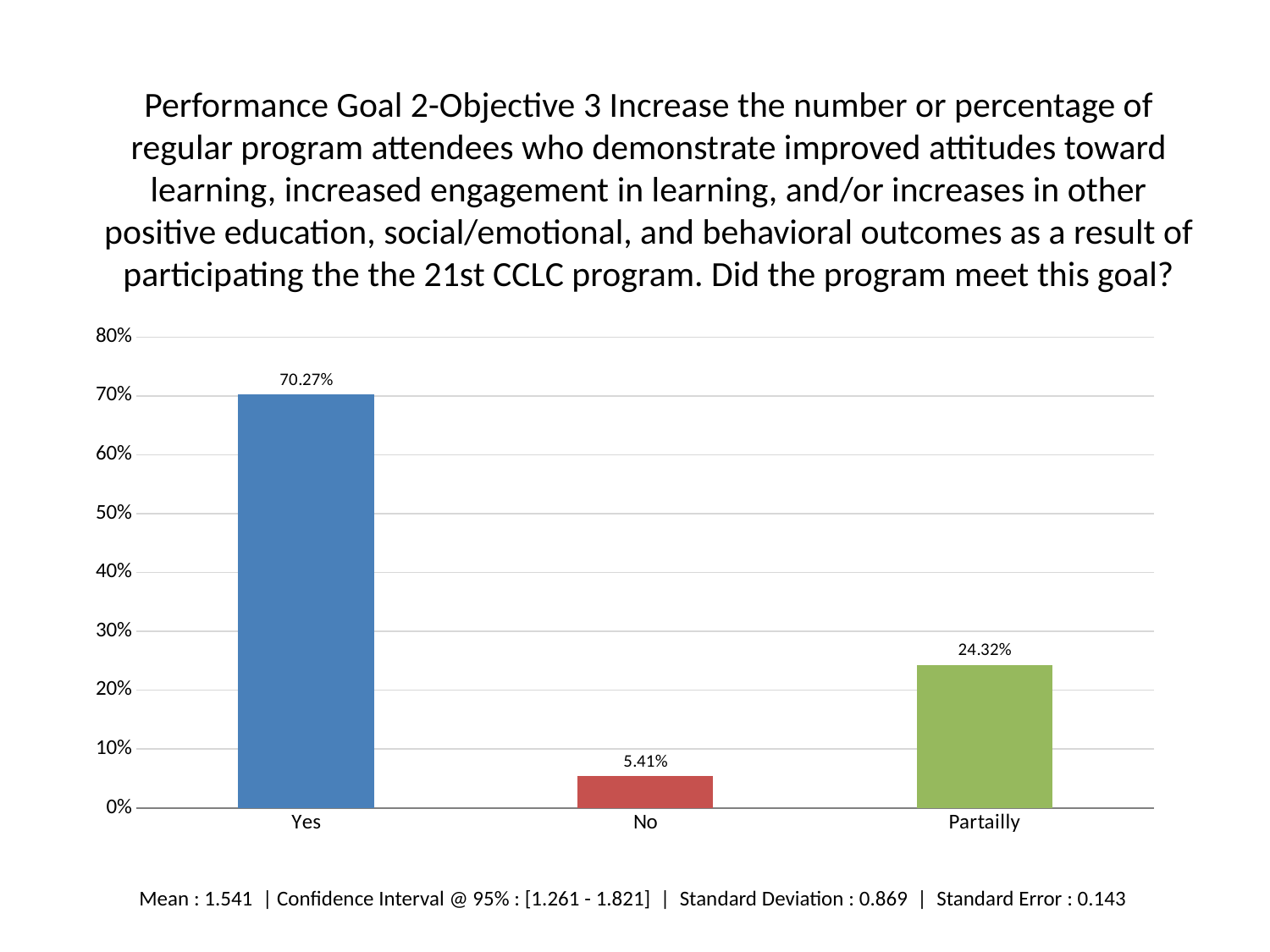
Which category has the lowest value? No What is the difference between the values for Yes and Partailly? 45.95% What is the value for No? 5.41% What is the difference between the values for Partailly and No? 18.91% What is the value for Yes? 70.27% Which is larger, the value for No or the value for Partailly? Partailly What colour is the bar for No? red Is the value for Yes greater or less than 60%? greater What is the value for Partailly? 24.32% What kind of chart is shown on the slide? bar chart How many categories are shown on the x axis? 3 Which category has the highest value? Yes